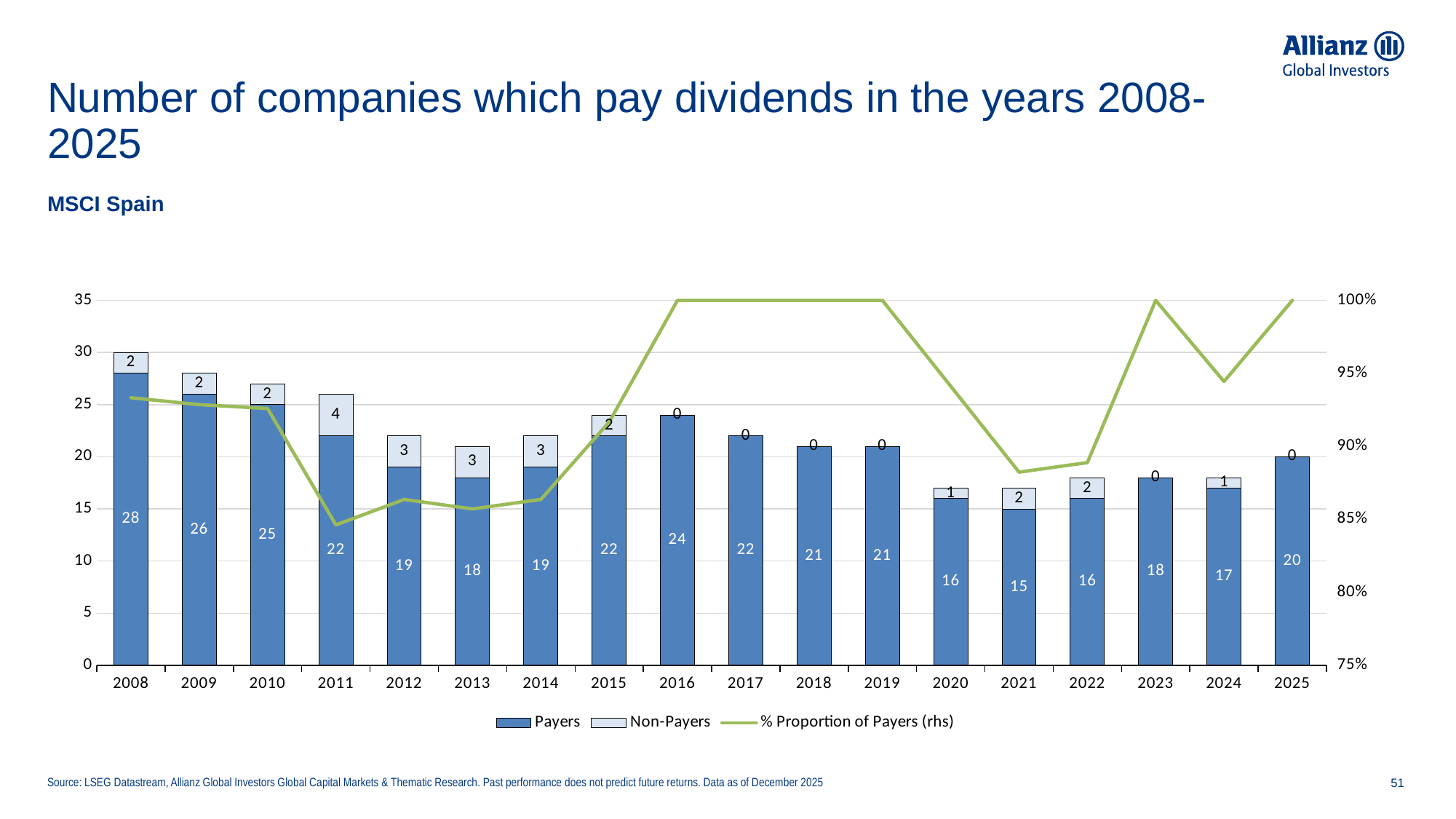
How many years are shown on the x axis? 18 What is the subtitle shown above the chart? MSCI Spain What is the difference between the number of Payers in 2008 and in 2025? 8 What is the total number of companies (Payers plus Non-Payers) in 2011? 26 What kind of chart is this? Stacked bar chart with a line Which year has more Payers, 2016 or 2017? 2016 How many Payers are shown for 2008? 28 Is the % Proportion of Payers for 2016 greater or less than 95%? greater In which year is the number of Payers lowest? 2021 What is the Non-Payers value for 2011? 4 How many series does the legend list? 3 In which year is the number of Payers highest? 2008